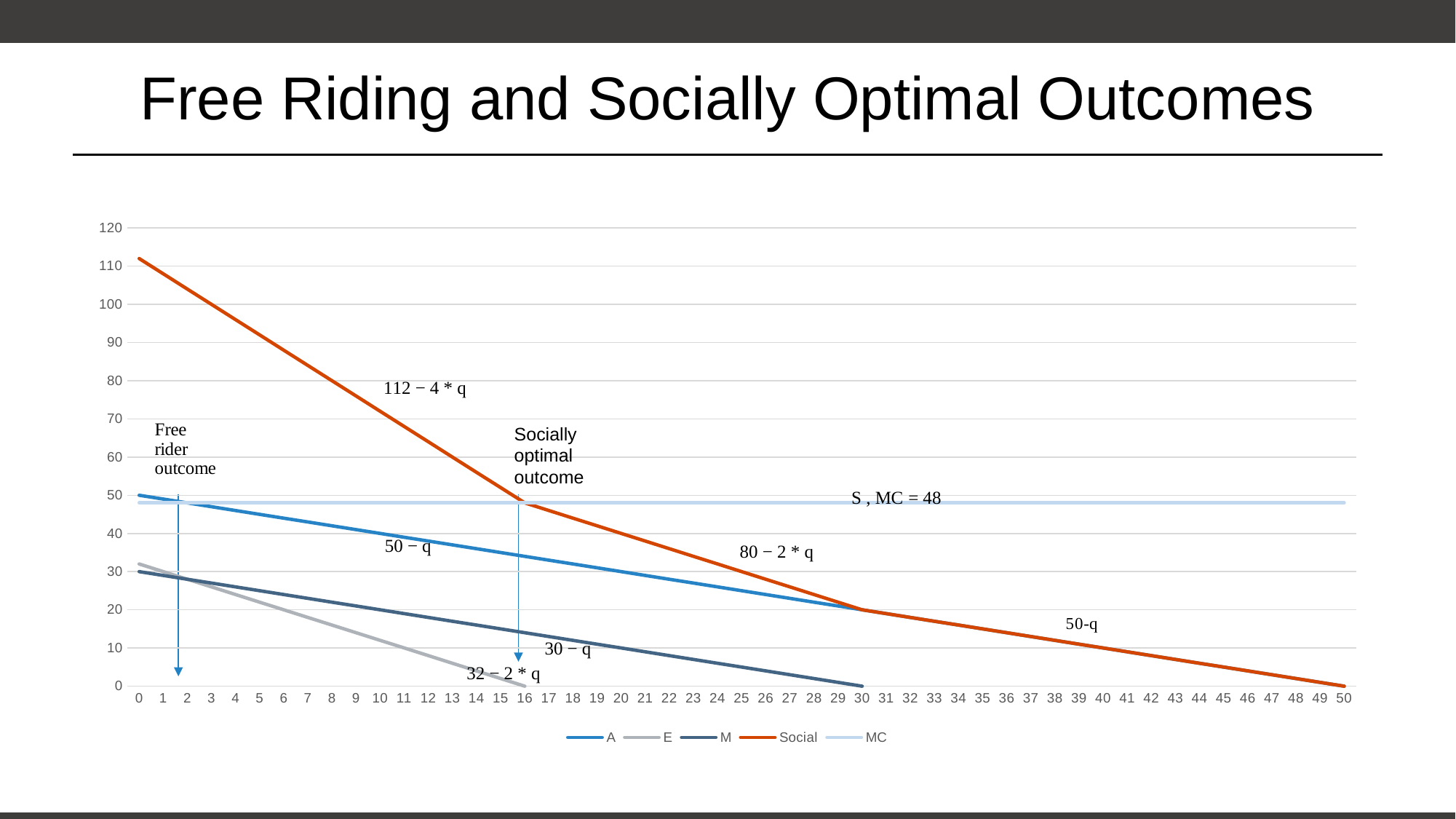
What label is written at the point where the Social line meets the MC line? Socially optimal outcome What formula is written next to the steepest segment of the Social line? 112 − 4 * q Is the value of the A line at q = 30 greater or less than 30? less What is the value of the MC line, as labelled on the chart? 48 At q = 10, which is larger, the E line or the M line? M How many series does the legend list? 5 Is the value of the Social line at q = 10 greater or less than 70? greater What kind of chart is shown on the slide? line chart At q = 0, which is larger, the A line or the M line? A Which series has the highest value at q = 0? Social Does the Social line rise or fall as q increases along the x axis? fall What is the value of the A line at q = 0? 50